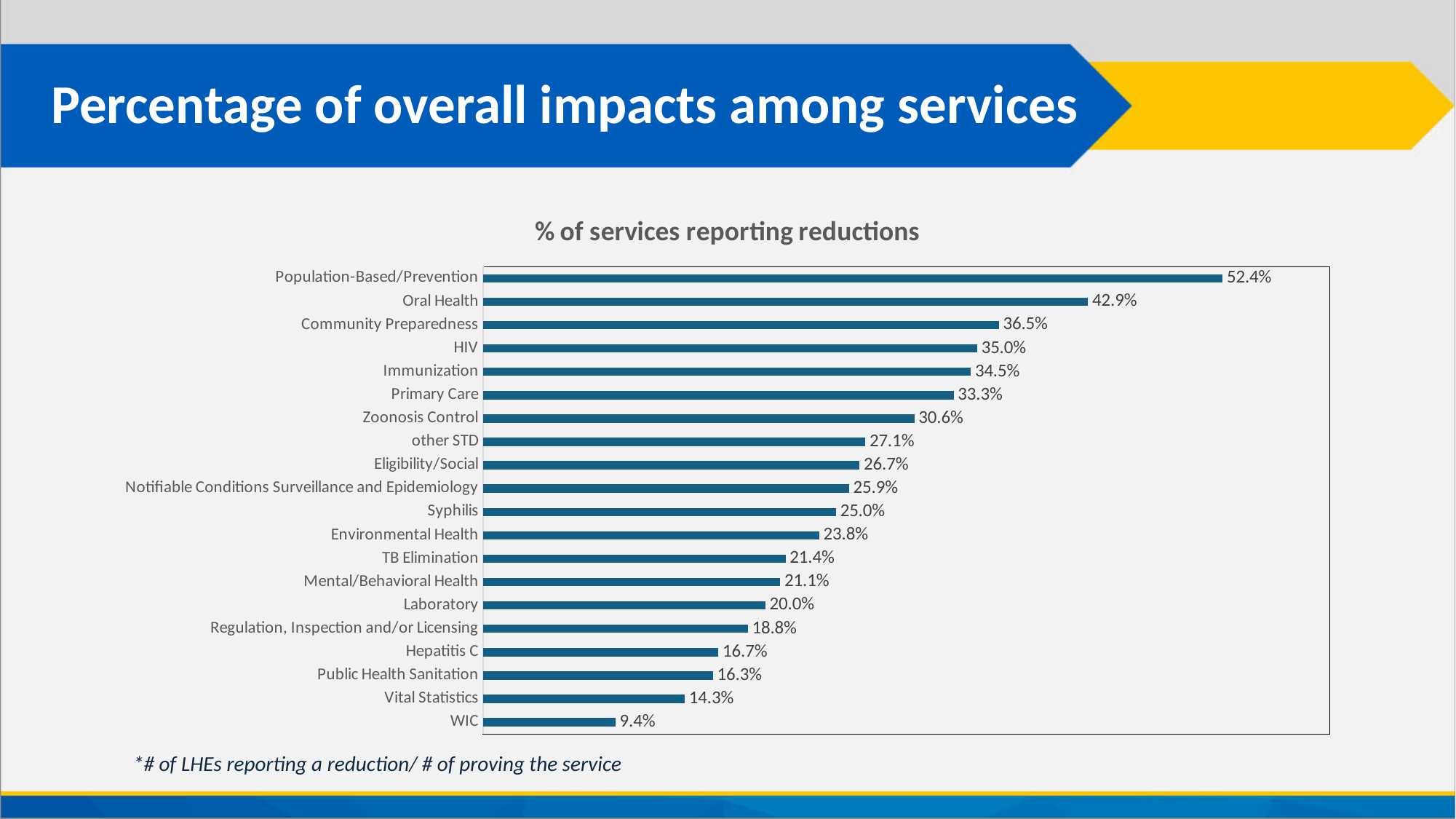
What is the difference between the values for Population-Based/Prevention and Oral Health? 9.5% Which is larger, the value for Laboratory or the value for Syphilis? Syphilis Which service has the highest percentage reporting reductions? Population-Based/Prevention What kind of chart is shown on the slide? Bar chart What is the value for Hepatitis C? 16.7% What is the value for Zoonosis Control? 30.6% What is the value for Oral Health? 42.9% What is the difference between the values for Immunization and Vital Statistics? 20.2% What is the title of the chart? % of services reporting reductions How many services are shown in the chart? 20 Which is larger, the value for Community Preparedness or the value for Primary Care? Community Preparedness Which service has the lowest percentage reporting reductions? WIC